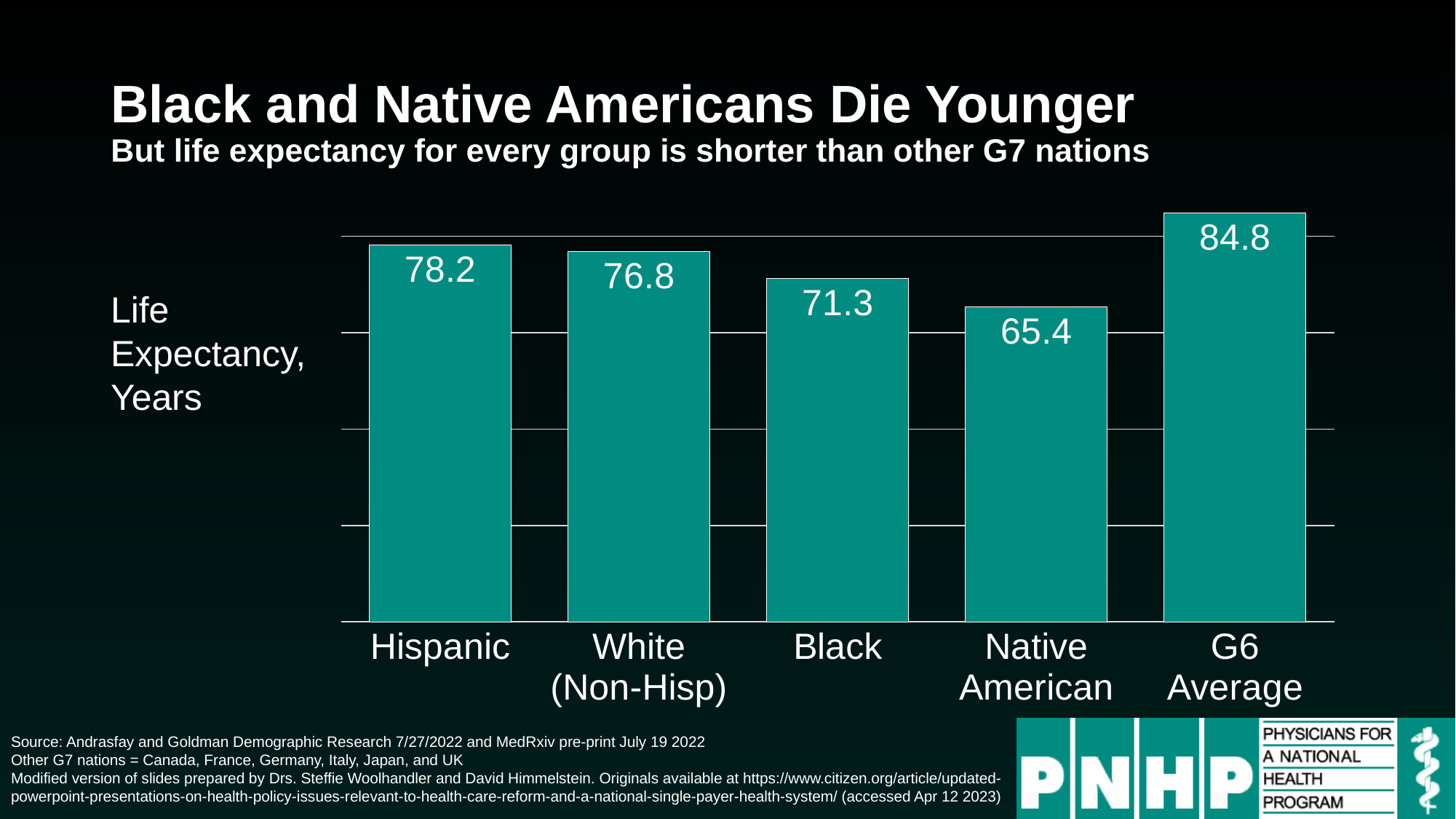
Which is larger, the life expectancy for Hispanic or for White (Non-Hisp)? Hispanic Which category has the highest life expectancy? G6 Average What is the life expectancy for White (Non-Hisp)? 76.8 What is the value for G6 Average? 84.8 Which category has the lowest life expectancy? Native American How many categories are shown in the chart? 5 What is the difference between the Hispanic and Black life expectancy? 6.9 What is the life expectancy for Black? 71.3 What kind of chart is shown on the slide? Bar chart What is the life expectancy for Native American? 65.4 What is the difference between the G6 Average and the Native American life expectancy? 19.4 What is the life expectancy for Hispanic? 78.2